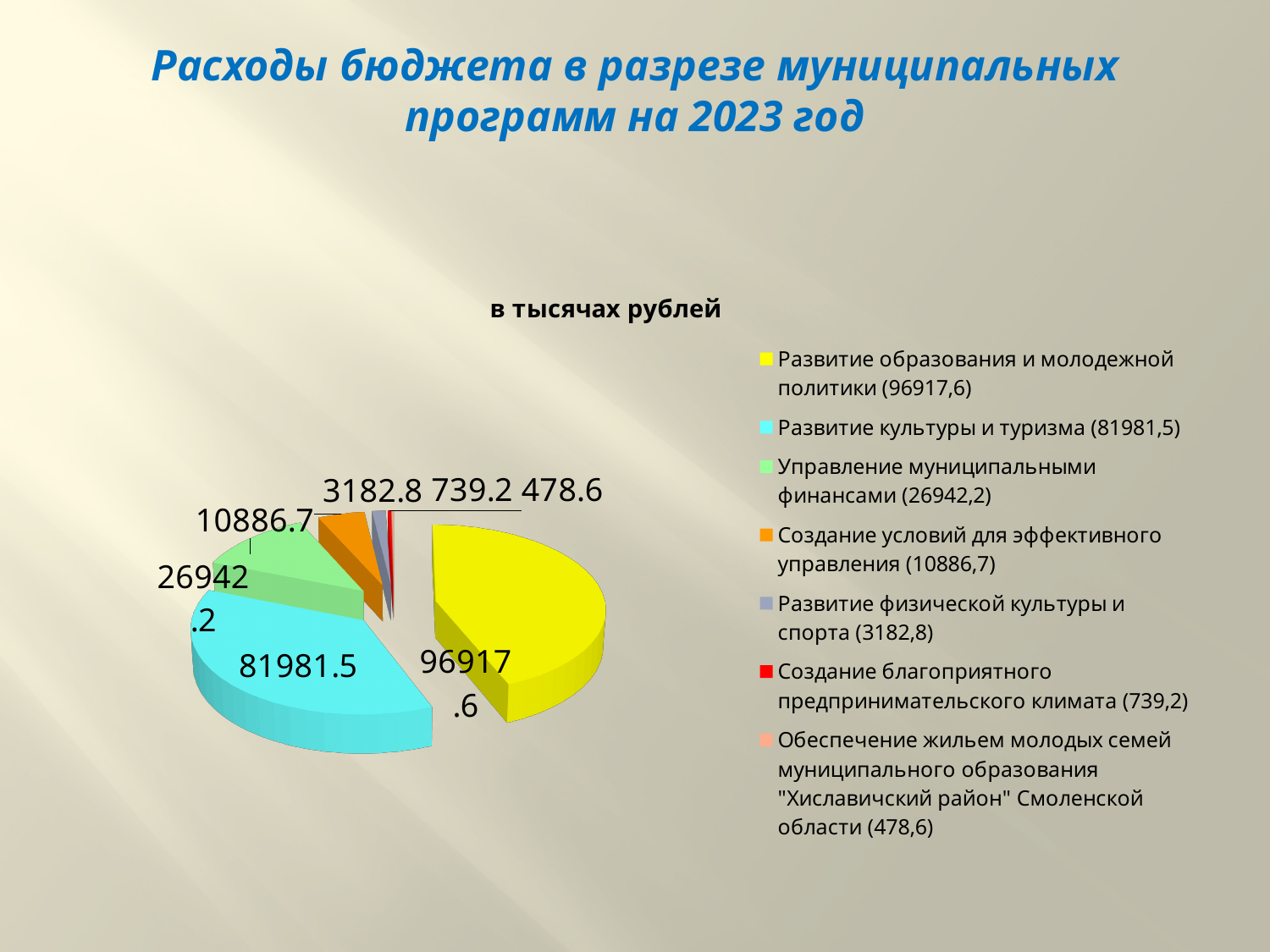
What is the value for Развитие образования и молодежной политики? 96917.6 What unit is stated in the chart title? в тысячах рублей What is the difference between the values for Развитие образования и молодежной политики and Развитие культуры и туризма? 14936.1 What kind of chart is shown on the slide? pie chart How many slices does the pie chart have? 7 What is the value for Развитие физической культуры и спорта? 3182.8 Which is larger: the value for Создание условий для эффективного управления or the value for Развитие физической культуры и спорта? Создание условий для эффективного управления What is the value for Управление муниципальными финансами? 26942.2 What is the value for Создание условий для эффективного управления? 10886.7 What is the value for Развитие культуры и туризма? 81981.5 Which program has the largest slice of the pie? Развитие образования и молодежной политики Which program has the smallest slice of the pie? Обеспечение жильем молодых семей муниципального образования "Хиславичский район" Смоленской области